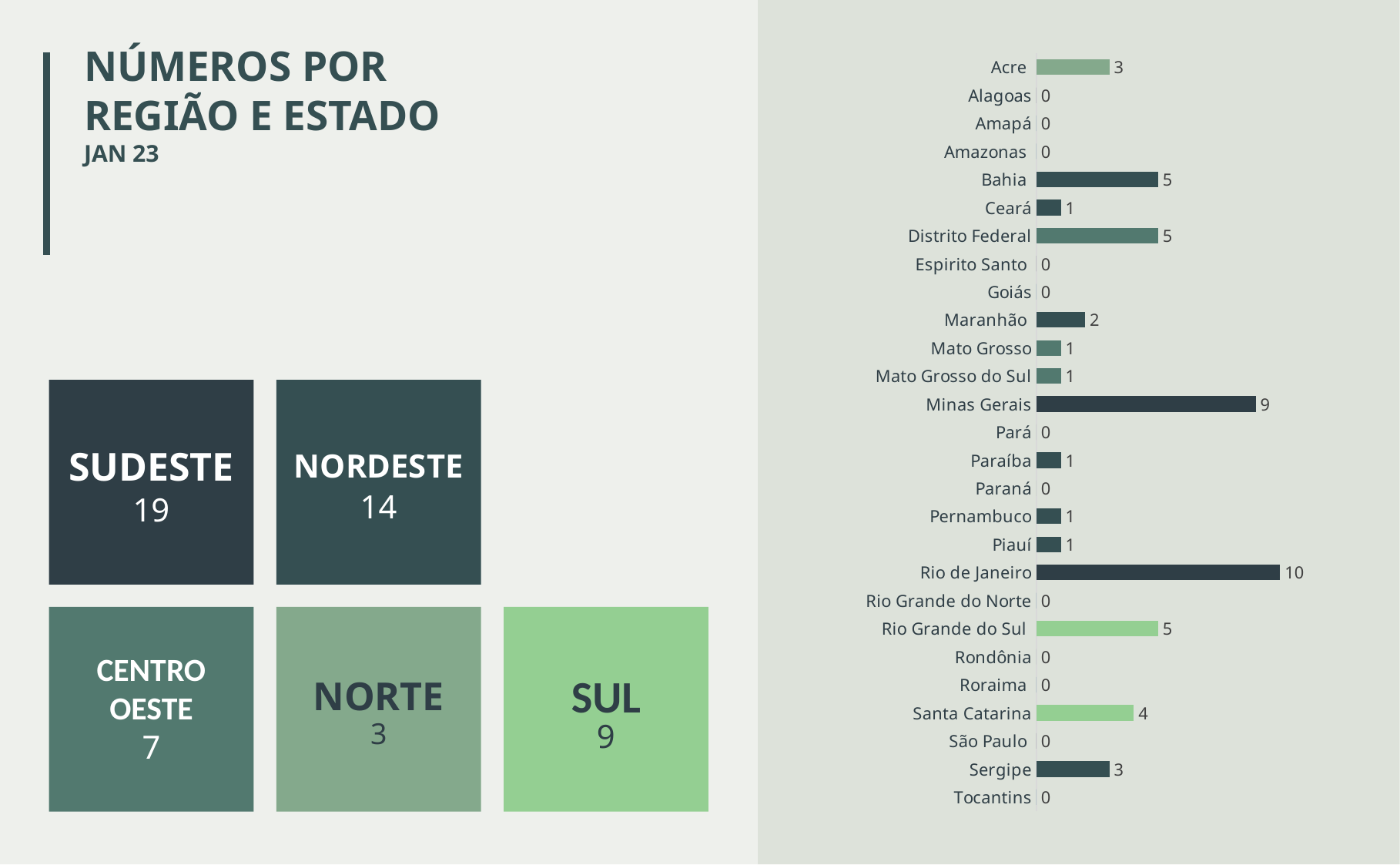
Which state has the highest value in the bar chart? Rio de Janeiro What is the difference between the values for Rio de Janeiro and Minas Gerais? 1 How many states in the bar chart have a value of 0? 12 What is the value for Minas Gerais in the bar chart? 9 How many states are listed in the bar chart? 27 What is the value for Maranhão in the bar chart? 2 What is the value for Rio de Janeiro in the bar chart? 10 What type of chart is shown on the right side of the slide? bar chart Which has a larger value, Rio Grande do Sul or Santa Catarina? Rio Grande do Sul What is the difference between the values for Bahia and Acre? 2 Which has a larger value, Sergipe or Ceará? Sergipe What is the value for Santa Catarina in the bar chart? 4